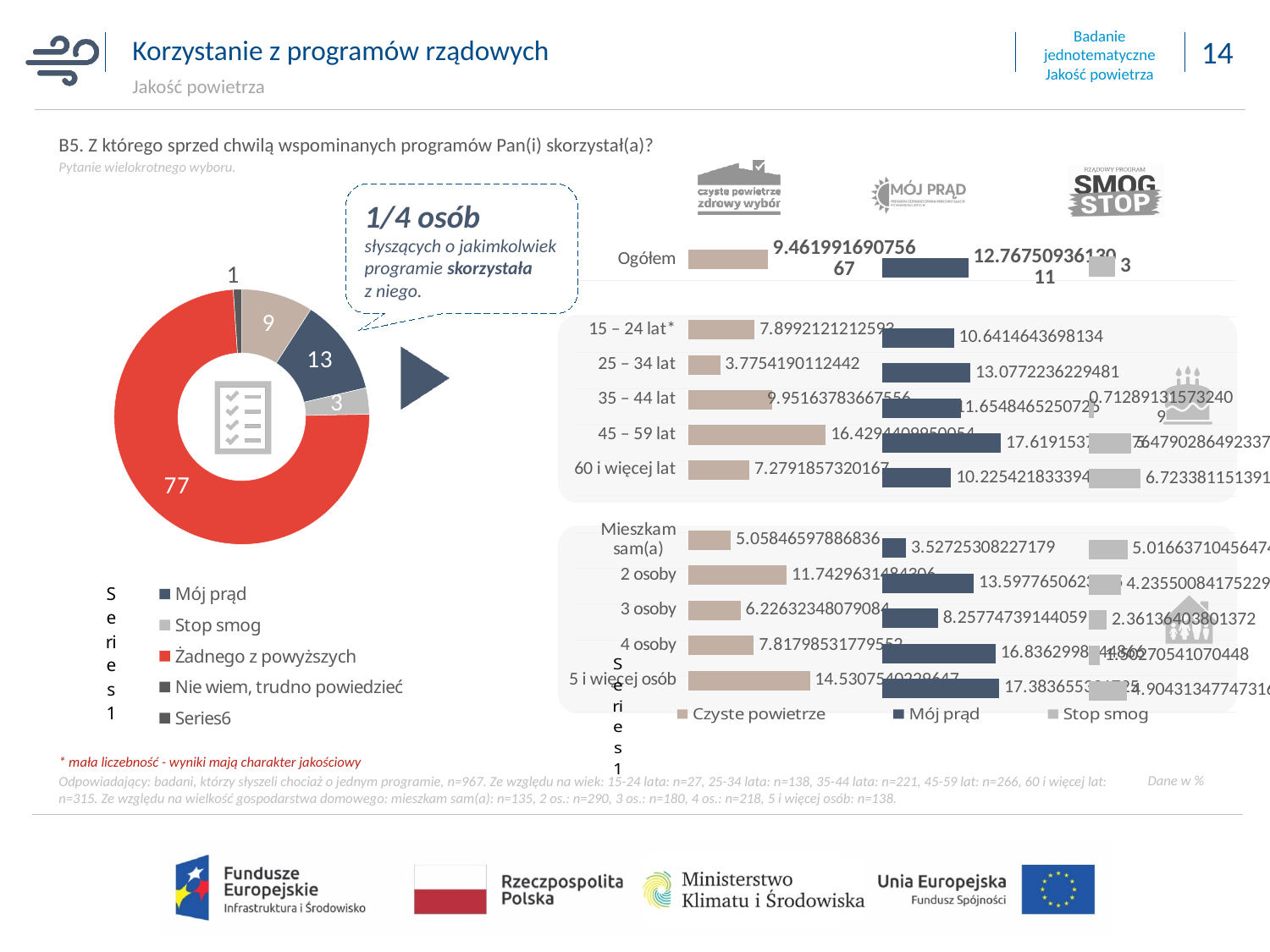
In the donut chart on the left, what is the difference between the values for Mój prąd and Stop smog? 10 In the bar chart on the right, which is larger for 3 osoby: Czyste powietrze or Mój prąd? Mój prąd In the bar chart on the right, what is the value of Mój prąd for 25 – 34 lat? 13.0772236229481 In the donut chart on the left, which category has the largest slice? Żadnego z powyższych What type of chart is the chart on the right side of the slide? Bar chart In the bar chart on the right, what is the value of Czyste powietrze for 15 – 24 lat? 7.8992121212593 In the donut chart on the left, what is the value for Żadnego z powyższych? 77 In the donut chart on the left, what is the value for Stop smog? 3 In the donut chart on the left, what is the value for Mój prąd? 13 In the bar chart on the right, what is the value of Stop smog for 3 osoby? 2.36136403801372 What type of chart is the chart on the left side of the slide? Donut (pie) chart In the bar chart on the right, how many series does the legend list? 3